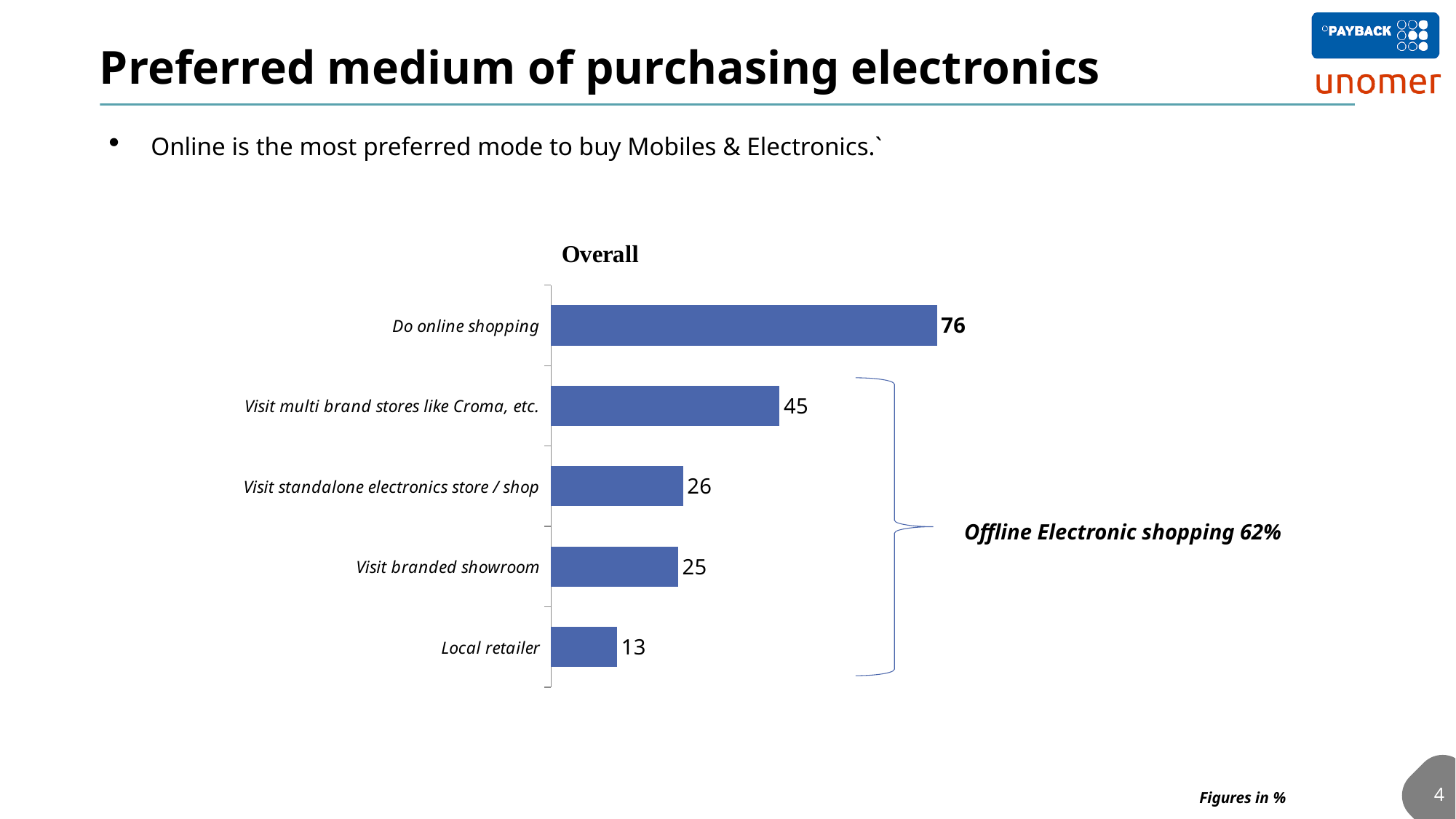
What is the value for Local retailer? 13 What is the value for Visit multi brand stores like Croma, etc.? 45 What kind of chart is shown on the slide? Bar chart What is the value for Visit standalone electronics store / shop? 26 Which is larger, the value for Visit branded showroom or the value for Local retailer? Visit branded showroom Which category has the lowest value? Local retailer How many categories are shown in the chart? 5 What is the difference between the values for Do online shopping and Visit multi brand stores like Croma, etc.? 31 What percentage does the bracket annotation give for Offline Electronic shopping? 62% Which category has the highest value? Do online shopping What is the value for Do online shopping? 76 What is the title of the chart? Overall